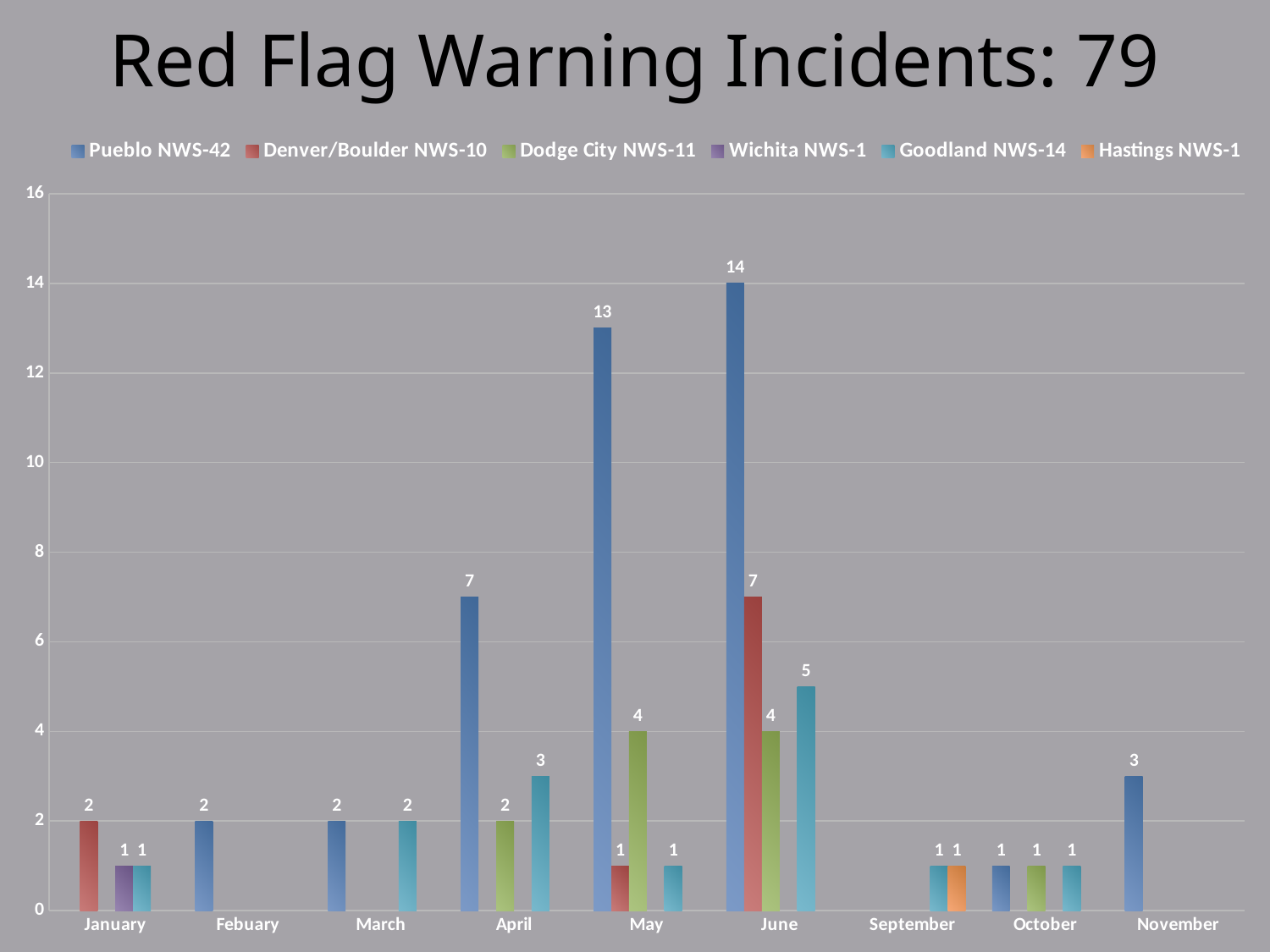
What type of chart is shown on the slide? bar chart What is the difference between the Pueblo NWS values for June and May? 1 What is the value for Goodland NWS in April? 3 How many series does the legend list? 6 What is the total number of incidents stated in the chart title? 79 Which series is shown in orange in the legend? Hastings NWS-1 In which month does Pueblo NWS reach its highest value? June Is the value for Pueblo NWS in May greater or less than 12? greater What is the value for Denver/Boulder NWS in June? 7 How many month categories are shown on the x axis? 9 Which is larger in June: the Dodge City NWS value or the Goodland NWS value? Goodland NWS What is the value for Pueblo NWS in June? 14